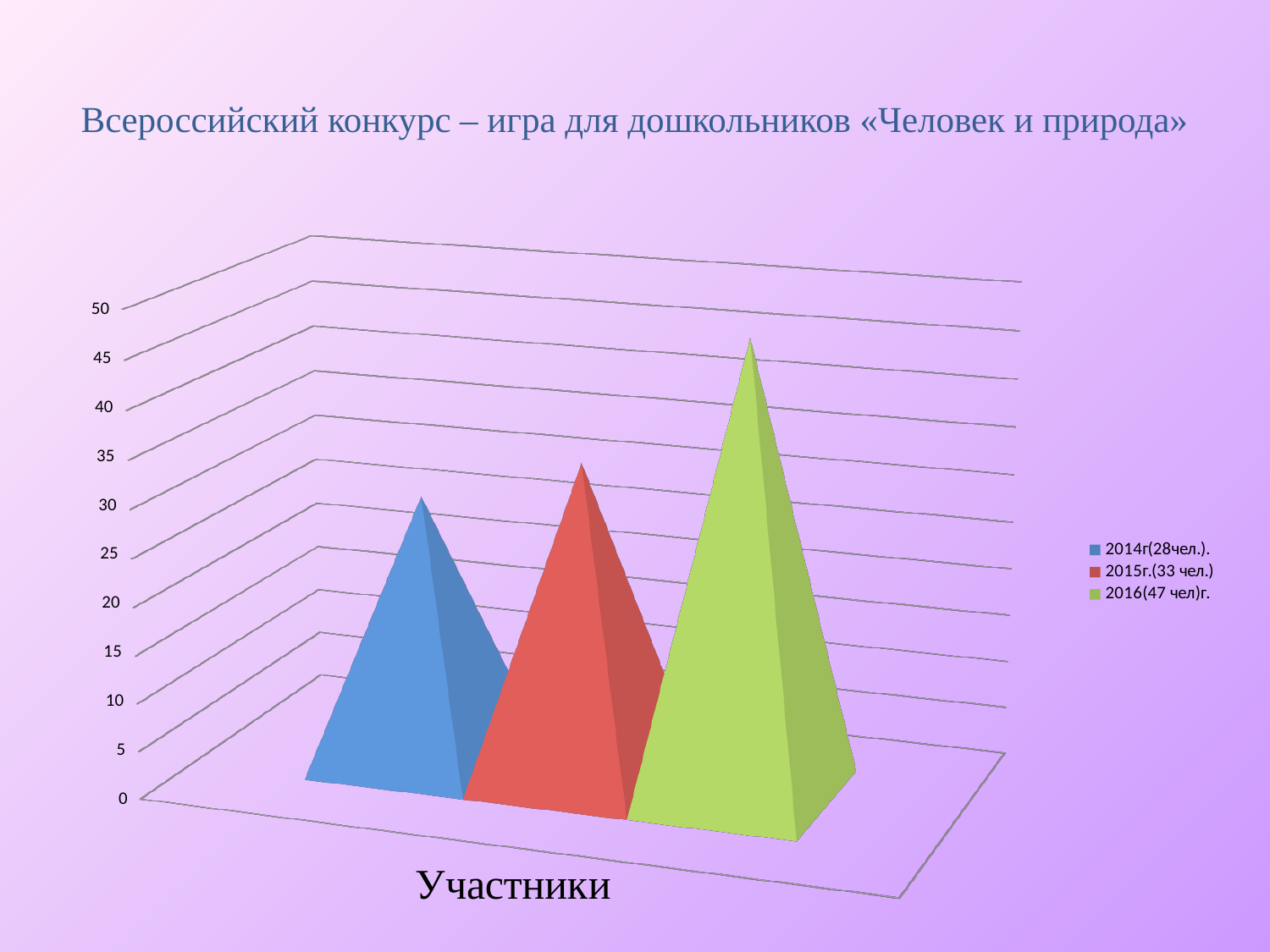
How many series does the legend list? 3 How many categories are shown on the horizontal axis? 1 What is the title of the slide above the chart? Всероссийский конкурс – игра для дошкольников «Человек и природа» According to the legend, how many participants (чел.) were there in 2015? 33 What is the difference in participants between 2016 and 2014? 19 According to the legend, how many participants (чел.) were there in 2016? 47 According to the legend, how many participants (чел.) were there in 2014? 28 Which year has the highest number of participants? 2016 What is the label of the category on the horizontal axis? Участники Is the value for 2016 greater or less than 40? greater What kind of chart is shown on the slide? bar chart Which year has the lowest number of participants? 2014